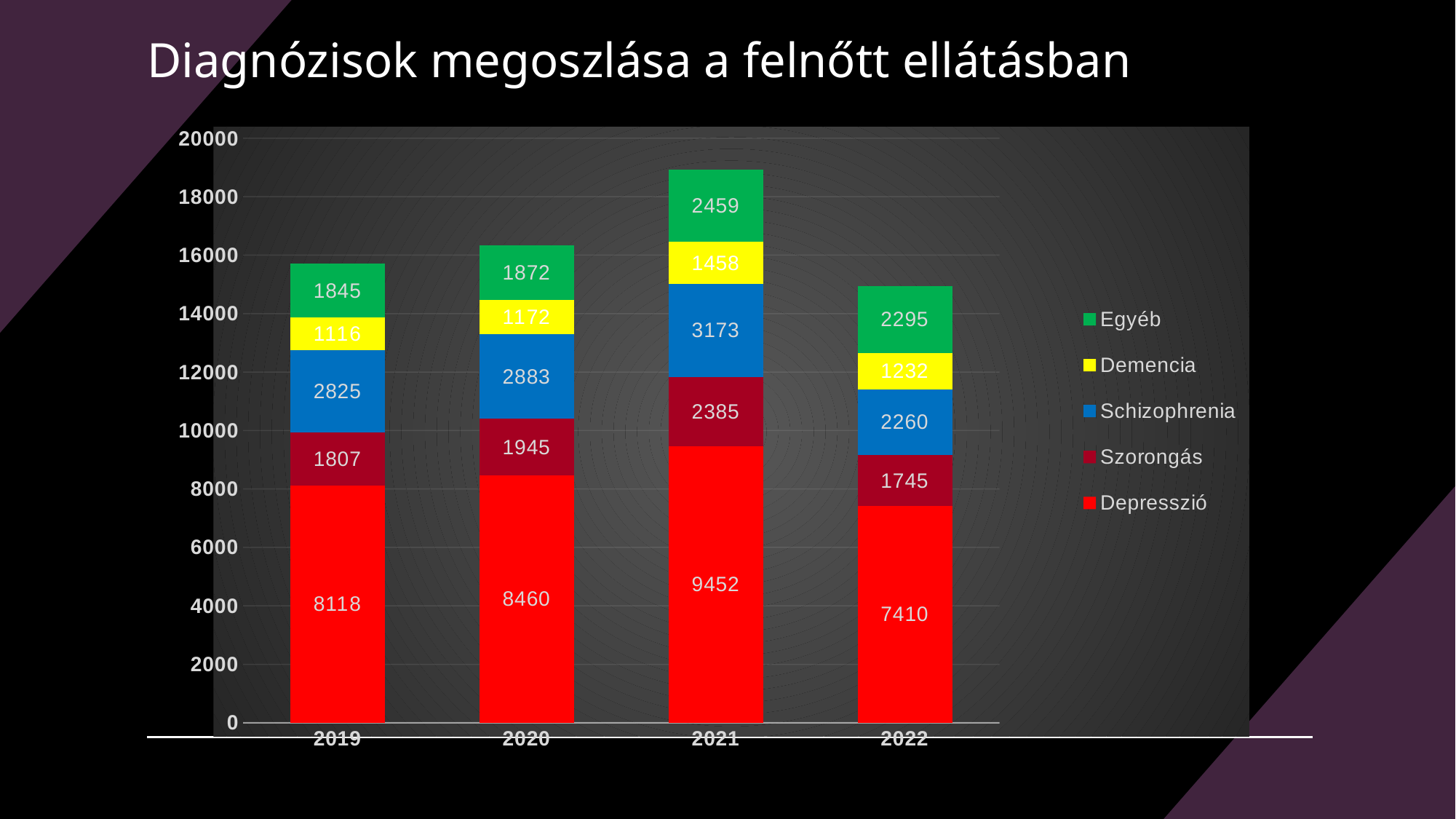
How many years are shown on the x axis? 4 Which is larger, the Schizophrenia value in 2019 or in 2022? 2019 How many series does the legend list? 5 What is the value for Demencia in 2022? 1232 In which year is the Egyéb value the lowest? 2019 What is the value for Depresszió in 2021? 9452 What is the difference between the Szorongás values in 2021 and 2022? 640 In which year is the Depresszió value the highest? 2021 What is the title of the chart? Diagnózisok megoszlása a felnőtt ellátásban What is the value for Schizophrenia in 2020? 2883 What type of chart is shown on the slide? stacked bar chart What is the total of the stacked bar for 2021? 18927